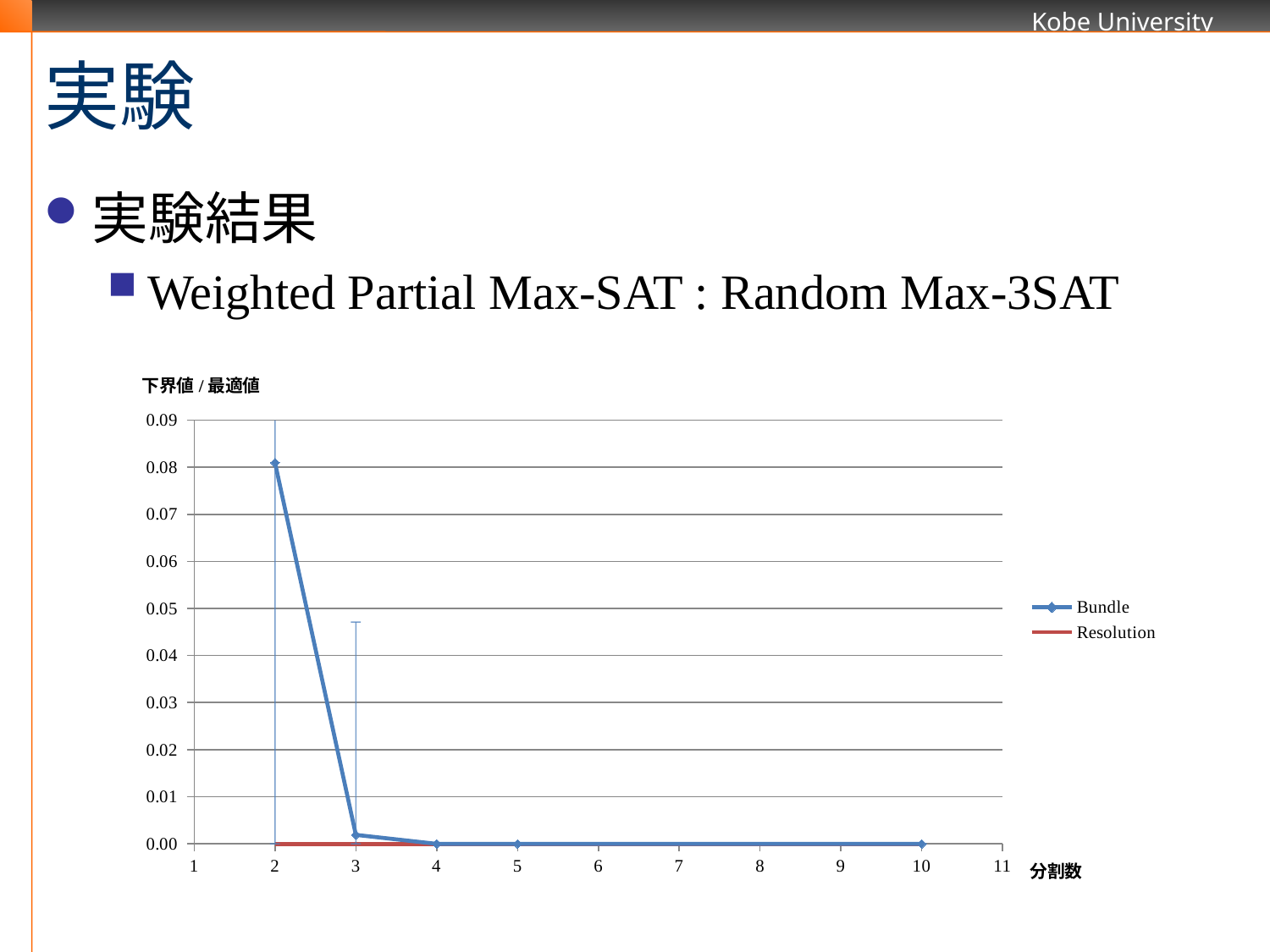
At which 分割数 value does the Bundle series reach its highest point? 2 Which is larger, the Bundle value at 分割数 2 or the Bundle value at 分割数 3? 分割数 2 Is the Bundle value at 分割数 3 greater or less than 0.01? less What are the two series named in the legend? Bundle and Resolution Is the Bundle value at 分割数 2 greater or less than 0.05? greater What kind of chart is shown on the slide? line chart What is the label of the x axis? 分割数 Is the Bundle value at 分割数 2 greater or less than 0.09? less Which series is drawn as a flat line along 0.00? Resolution Does the Bundle series rise or fall as 分割数 increases from 2 to 4? fall How many series does the legend list? 2